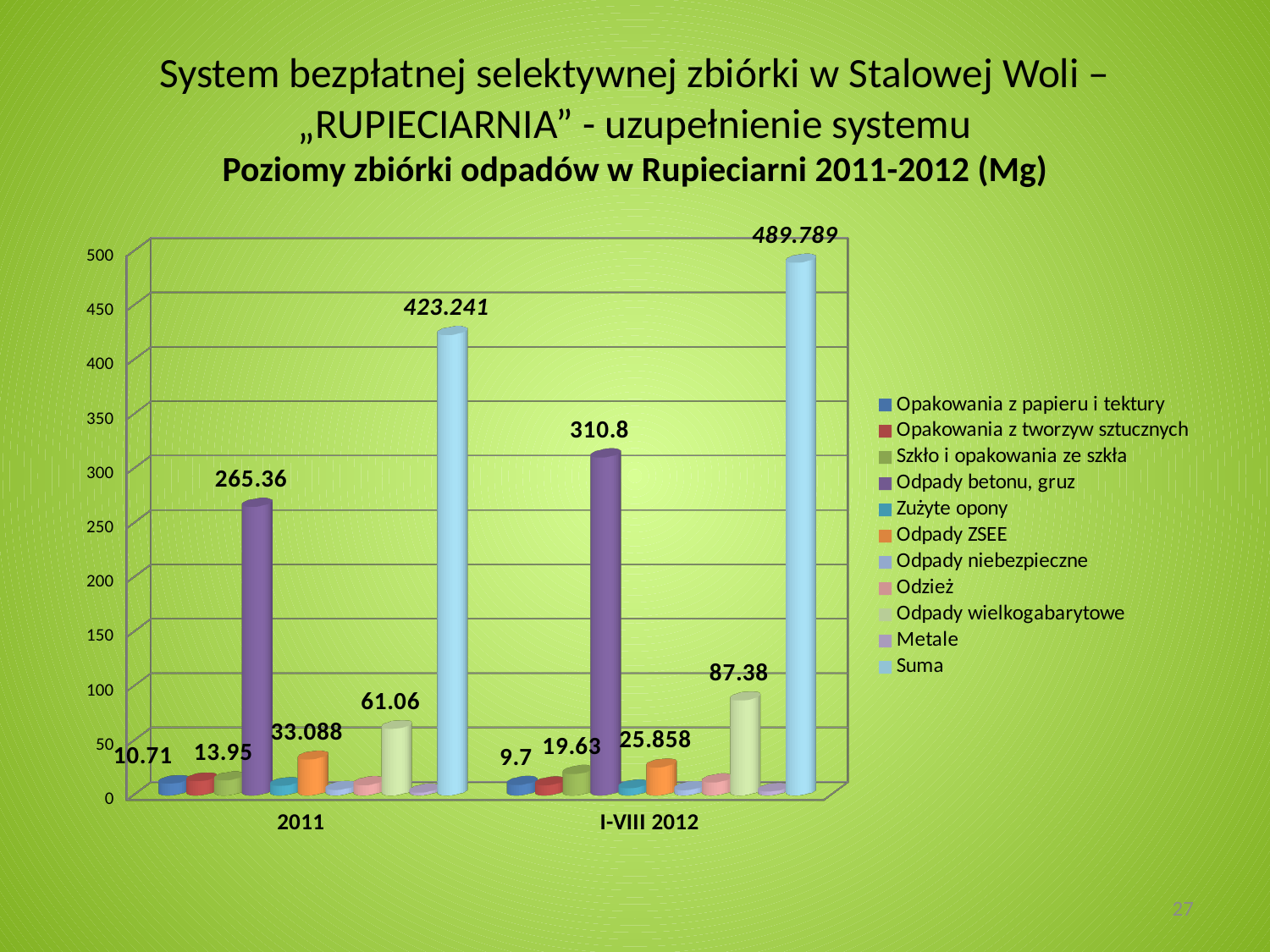
What is the value of Suma for I-VIII 2012? 489.789 What is the difference between Odpady betonu, gruz in I-VIII 2012 and in 2011? 45.44 How many series does the legend list? 11 What is the value of Odpady ZSEE for 2011? 33.088 What is the value of Odpady wielkogabarytowe for I-VIII 2012? 87.38 What is the value of Odpady betonu, gruz for I-VIII 2012? 310.8 By how much did Suma increase from 2011 to I-VIII 2012? 66.548 Which period has the larger value for Odpady ZSEE, 2011 or I-VIII 2012? 2011 What is the value of Odpady betonu, gruz for 2011? 265.36 Which series has the highest value in 2011? Suma What is the value of Suma for 2011? 423.241 What kind of chart is shown on the slide? Bar chart